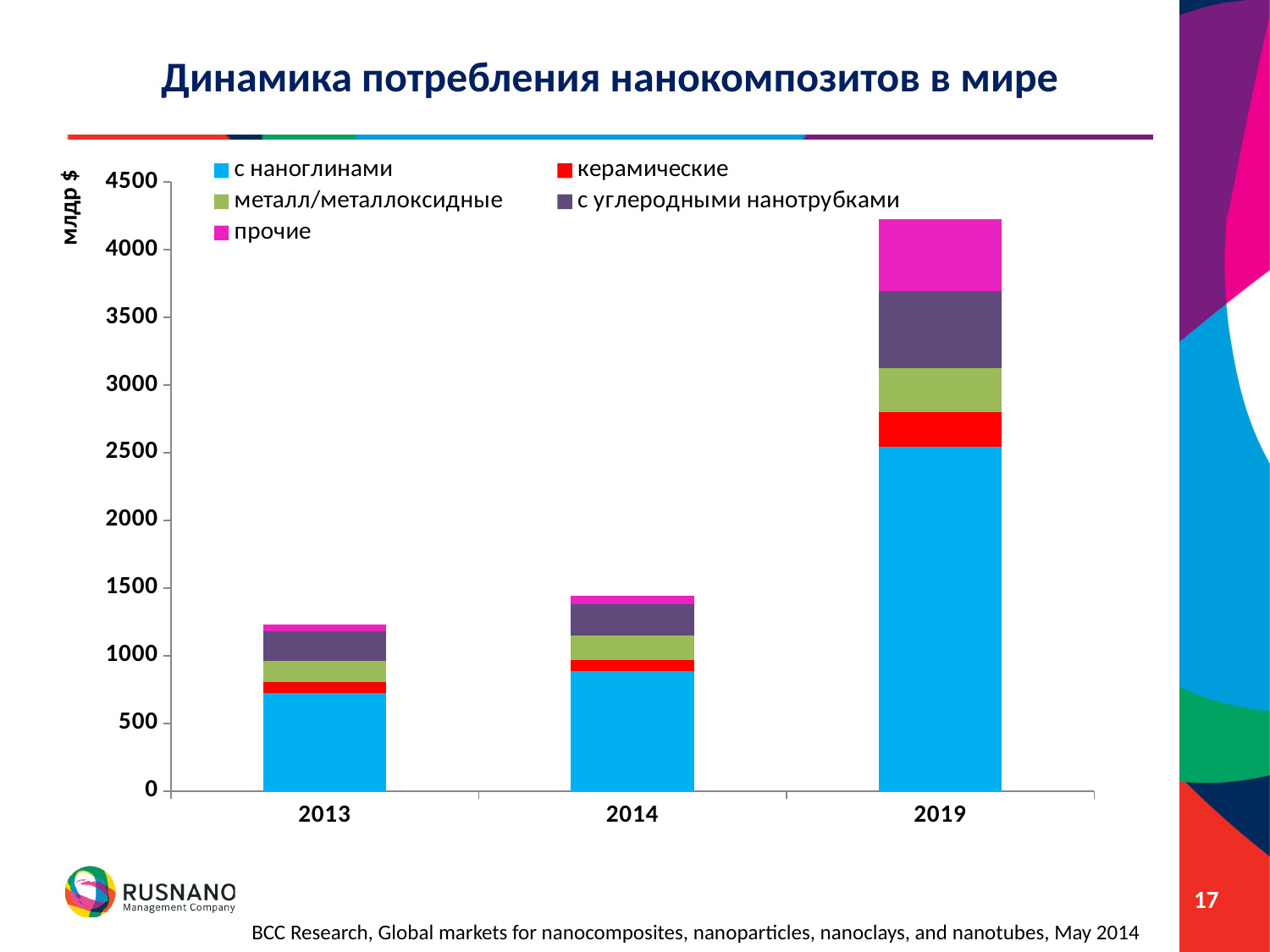
How many years (categories) are shown on the x axis of the chart? 3 Which year has the tallest stacked bar in the chart? 2019 Which year has the shortest stacked bar in the chart? 2013 Is the total value of the 2014 bar greater or less than 1500? less Do the total bar heights rise or fall from 2013 to 2019? rise Which series is shown in light blue at the bottom of each stacked bar? с наноглинами What kind of chart is shown on the slide? stacked bar chart Is the total value of the 2013 bar greater or less than 1000? greater What is the title of the chart on the slide? Динамика потребления нанокомпозитов в мире How many series does the chart legend list? 5 Is the total value of the 2019 bar greater or less than 4000? greater Which bar is taller, 2014 or 2013? 2014